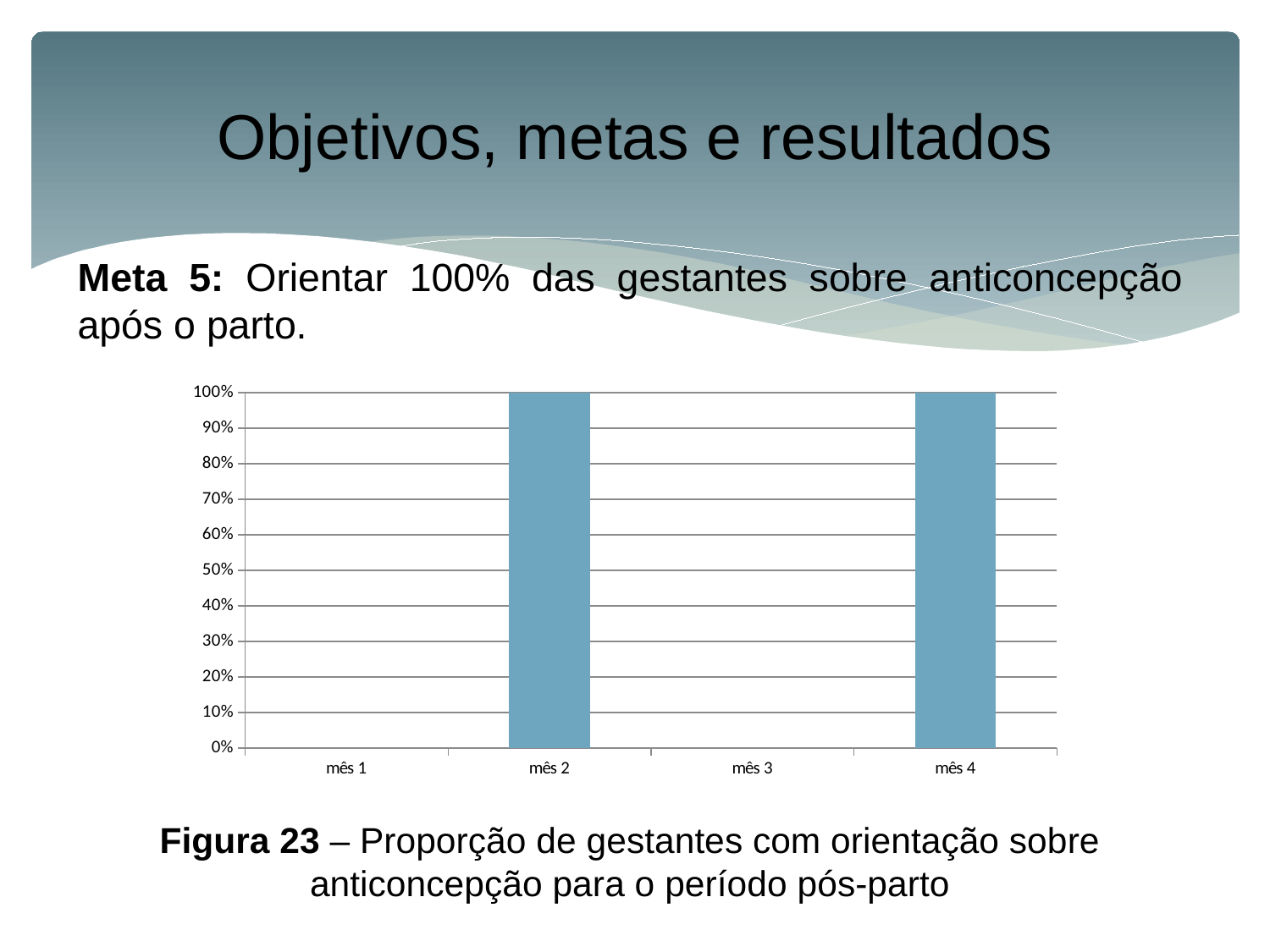
What is the difference between the values for mês 2 and mês 4? 0% What is the highest value shown on the y axis of the chart? 100% What kind of chart is shown on the slide? bar chart Is the value for mês 4 greater or less than 90%? greater Which is larger, the value for mês 2 or the value for mês 1? mês 2 What is the value for mês 2? 100% How many categories have a visible bar in the chart? 2 What is the value for mês 4? 100% How many categories are shown on the x axis of the chart? 4 Is the value for mês 2 greater or less than 50%? greater What is the figure number given in the caption below the chart? Figura 23 Which is larger, the value for mês 4 or the value for mês 3? mês 4